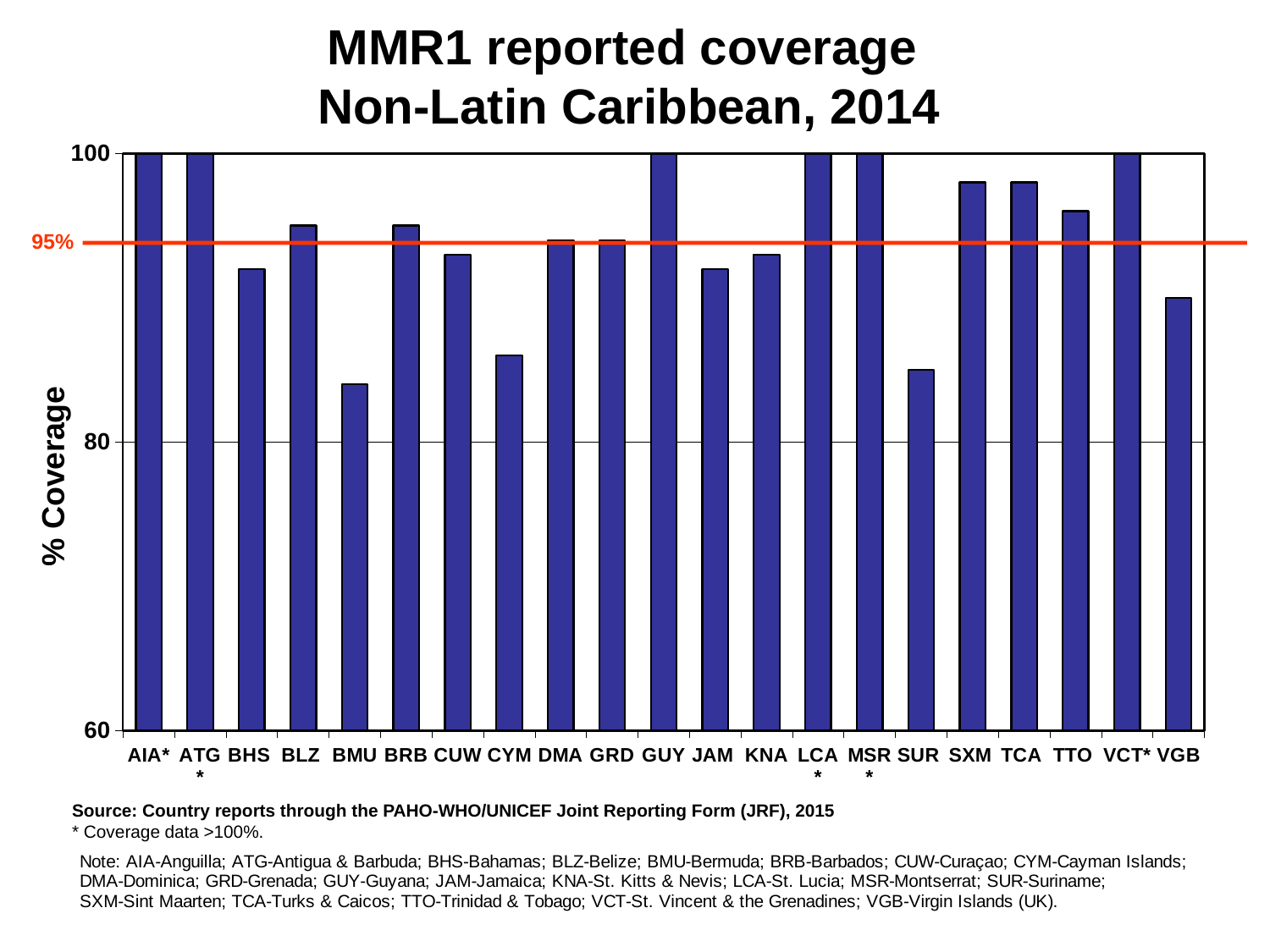
What is the label of the y axis? % Coverage Is the value for BMU greater or less than 95? less How many countries are shown on the x axis of the chart? 21 Is the value for SXM greater or less than 95? greater What value does the horizontal red reference line mark on the chart? 95% Is the value for SUR greater or less than 95? less Which country has the lowest MMR1 reported coverage on the chart? BMU What kind of chart is shown on the slide? bar chart Which has the higher value, VGB or CYM? VGB